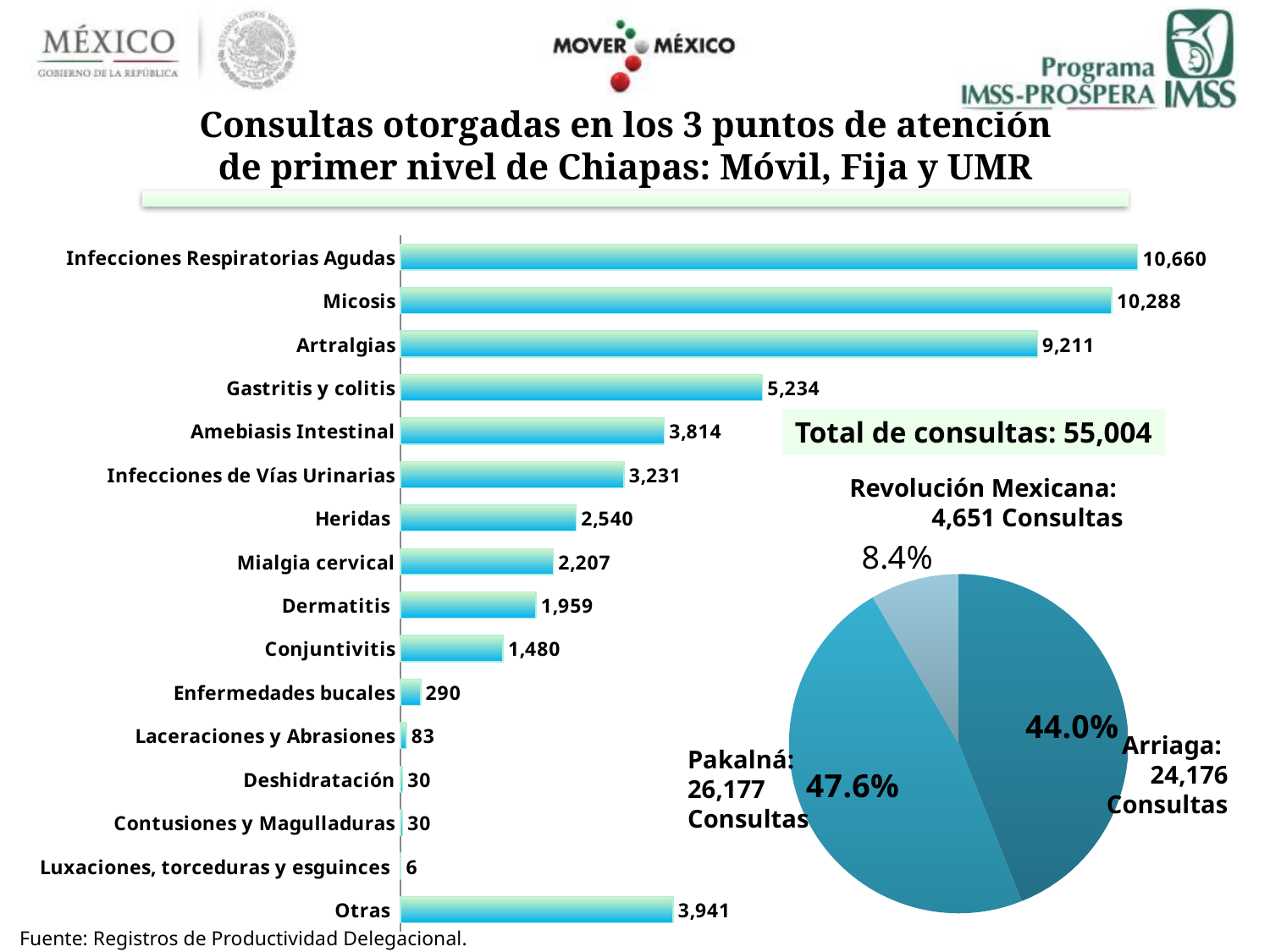
How many categories does the bar chart show? 16 What kind of chart is the chart on the left of the slide? Bar chart In the bar chart, how many consultas are shown for Micosis? 10,288 In the bar chart, what is the value for Gastritis y colitis? 5,234 In the pie chart, what share of consultas corresponds to Pakalná? 47.6% In the pie chart, how many consultas are shown for Arriaga? 24,176 In the pie chart, which location has the smallest slice? Revolución Mexicana In the bar chart, what is the difference between Infecciones Respiratorias Agudas and Micosis? 372 In the bar chart, which is larger: Heridas or Mialgia cervical? Heridas In the bar chart, which category has the highest number of consultas? Infecciones Respiratorias Agudas In the bar chart, which category has the lowest value? Luxaciones, torceduras y esguinces What total number of consultas is stated on the slide? 55,004